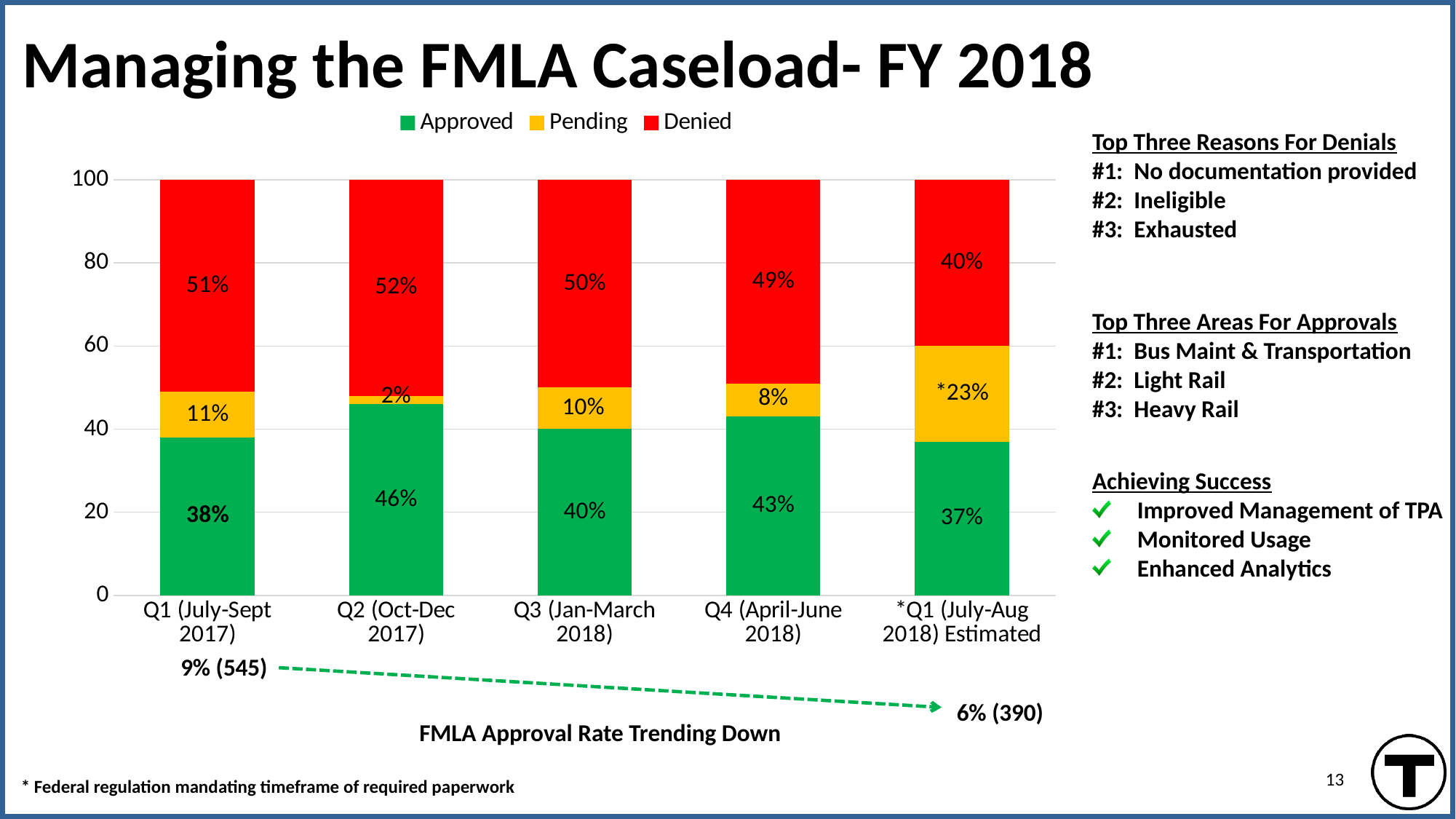
What is the Approved percentage for Q2 (Oct-Dec 2017)? 46% Which quarter has the lowest Pending percentage? Q2 (Oct-Dec 2017) What is the Pending percentage for *Q1 (July-Aug 2018) Estimated? *23% Which is larger, the Approved percentage for Q3 (Jan-March 2018) or for Q4 (April-June 2018)? Q4 (April-June 2018) What is the total of the stacked bar for Q1 (July-Sept 2017)? 100% What is the difference between the Denied percentage in Q2 (Oct-Dec 2017) and in *Q1 (July-Aug 2018) Estimated? 12% What is the Denied percentage for Q4 (April-June 2018)? 49% How many quarters (categories) are plotted on the x axis? 5 Which quarter has the highest Approved percentage? Q2 (Oct-Dec 2017) How many series does the legend list? 3 What kind of chart is shown on the slide? Stacked bar chart Which colour represents the Denied series in the legend? Red